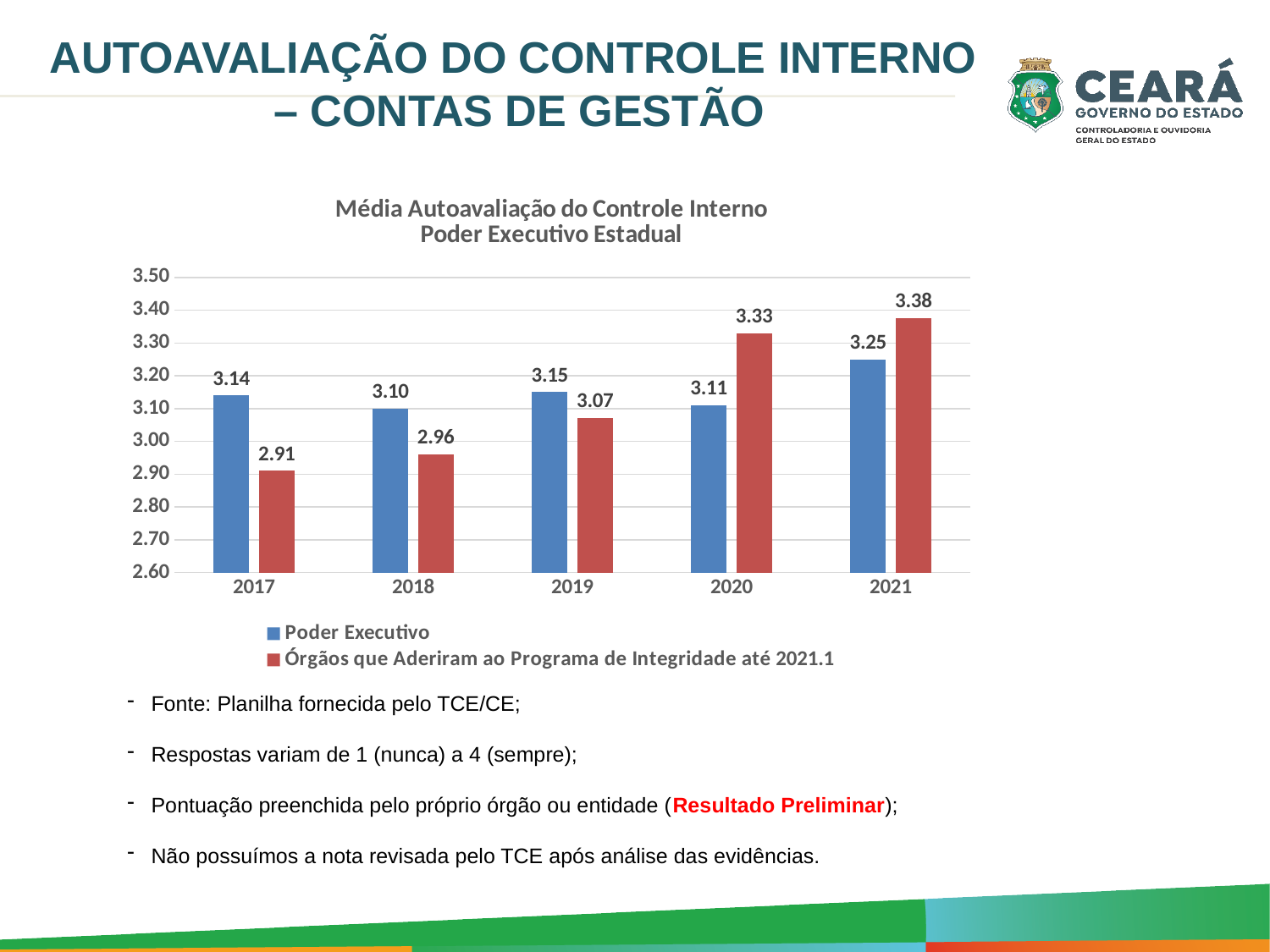
In which year is the value for Poder Executivo highest? 2021 In which year is the value for Órgãos que Aderiram ao Programa de Integridade até 2021.1 lowest? 2017 What is the difference between the two series in 2020? 0.22 How many years are shown on the x axis? 5 What is the value for Poder Executivo in 2017? 3.14 How many series does the legend list? 2 Which series has the larger value in 2018? Poder Executivo What is the value for Poder Executivo in 2020? 3.11 What is the value for Órgãos que Aderiram ao Programa de Integridade até 2021.1 in 2021? 3.38 Does the value for Órgãos que Aderiram ao Programa de Integridade até 2021.1 rise or fall from 2017 to 2021? Rise Which series has the larger value in 2021? Órgãos que Aderiram ao Programa de Integridade até 2021.1 What kind of chart is shown? Bar chart